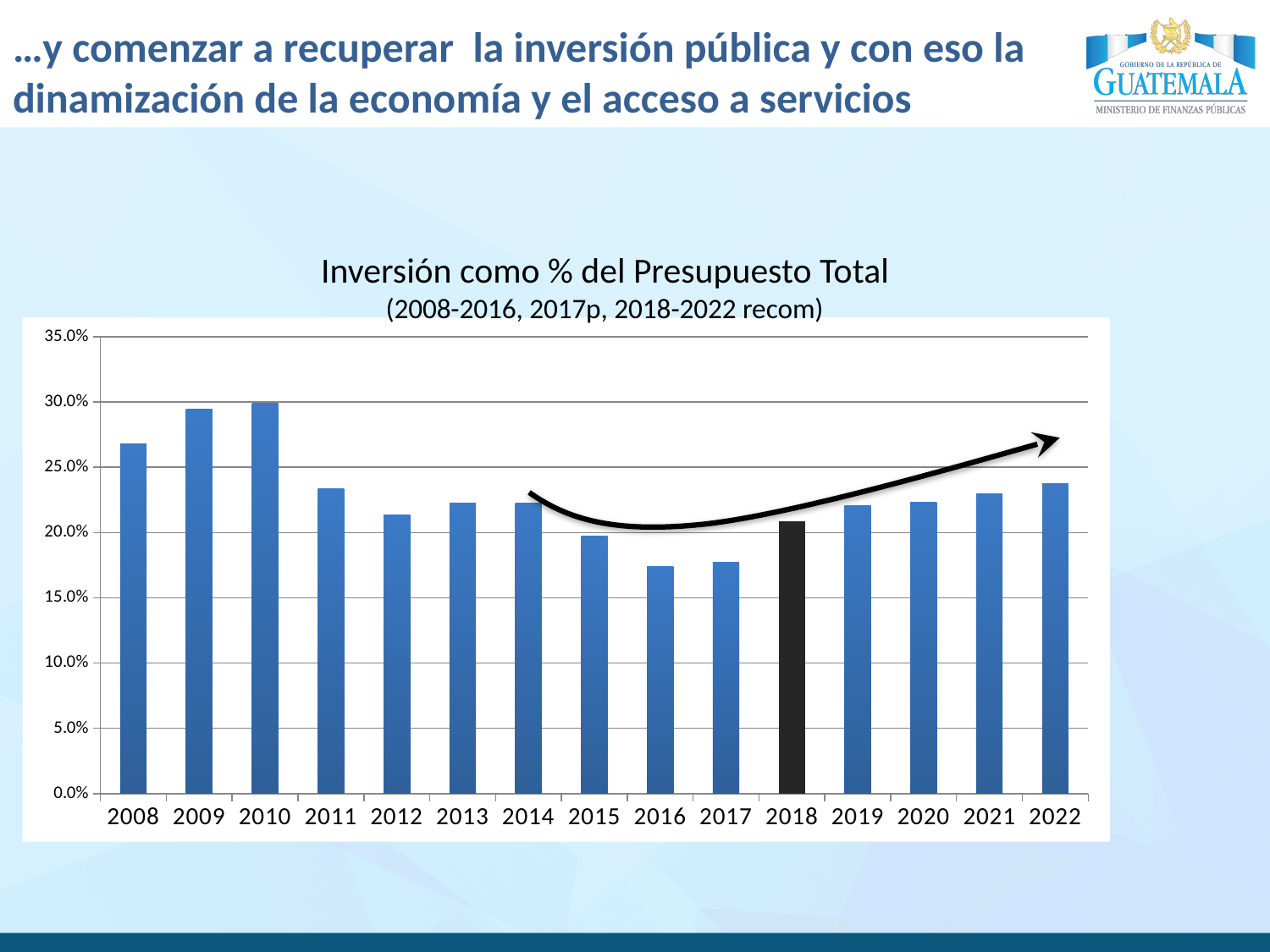
Which year has the highest investment as a percentage of the total budget? 2010 Is the value for 2012 greater or less than 20.0%? greater Do the values rise or fall from 2018 to 2022? rise Which year's bar is shown in a different (dark) colour from the others? 2018 Is the value for 2022 greater or less than 25.0%? less What is the title of the chart? Inversión como % del Presupuesto Total How many years are shown on the x axis of the chart? 15 Which is larger, the value for 2021 or the value for 2016? 2021 Is the value for 2016 greater or less than 20.0%? less Which is larger, the value for 2008 or the value for 2022? 2008 What kind of chart is shown on the slide? bar chart